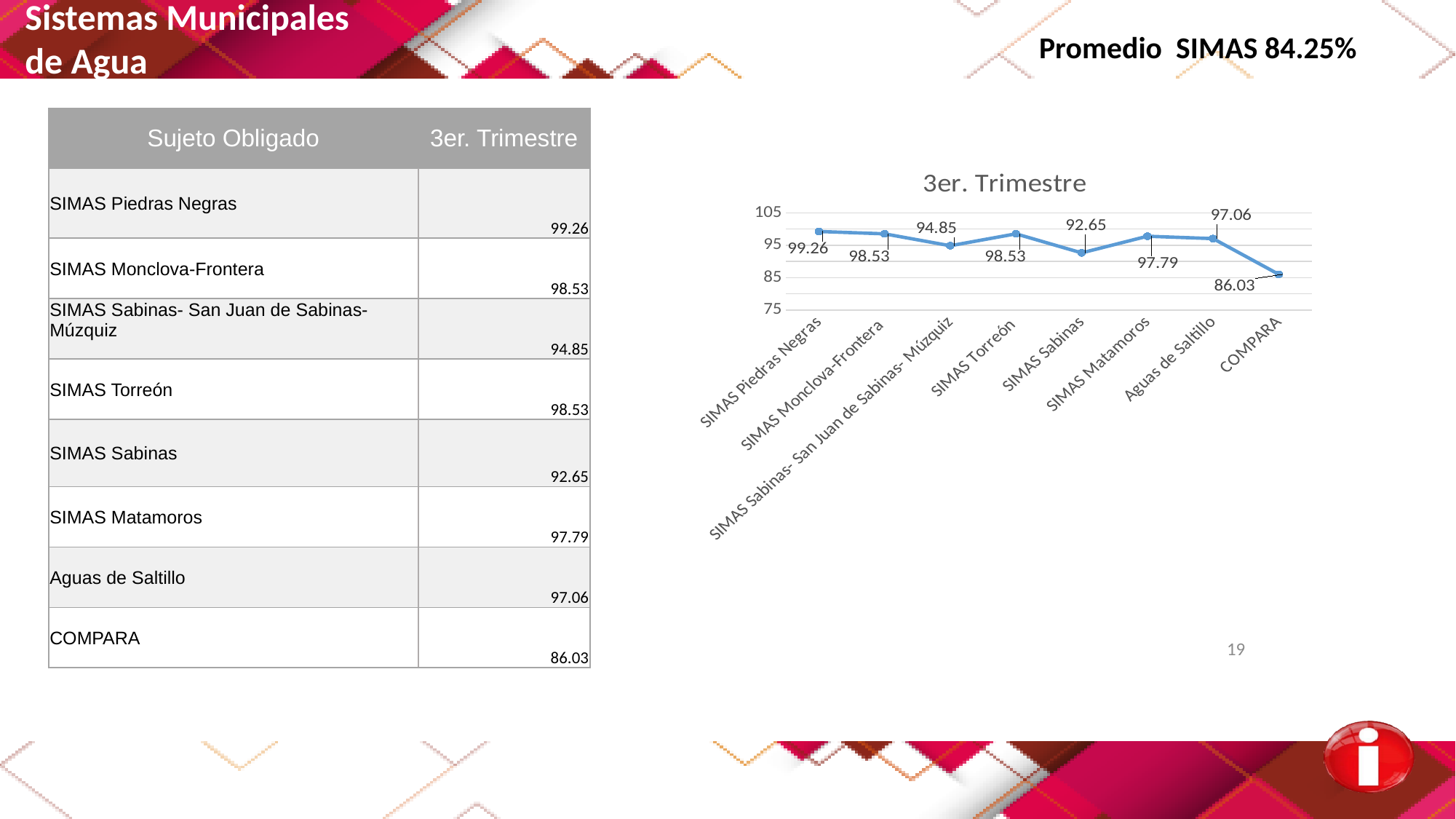
What is the difference between the values for SIMAS Piedras Negras and COMPARA? 13.23 What kind of chart is shown on the slide? Line chart What is the difference between the values for SIMAS Matamoros and Aguas de Saltillo? 0.73 Which category has the highest value in the chart? SIMAS Piedras Negras Which is larger, the value for SIMAS Sabinas or the value for SIMAS Matamoros? SIMAS Matamoros What is the value for Aguas de Saltillo in the chart? 97.06 What is the value for SIMAS Piedras Negras in the chart? 99.26 What is the value for COMPARA in the chart? 86.03 Which category has the lowest value in the chart? COMPARA What is the value for SIMAS Sabinas in the chart? 92.65 What is the title of the chart? 3er. Trimestre How many categories are plotted in the chart? 8